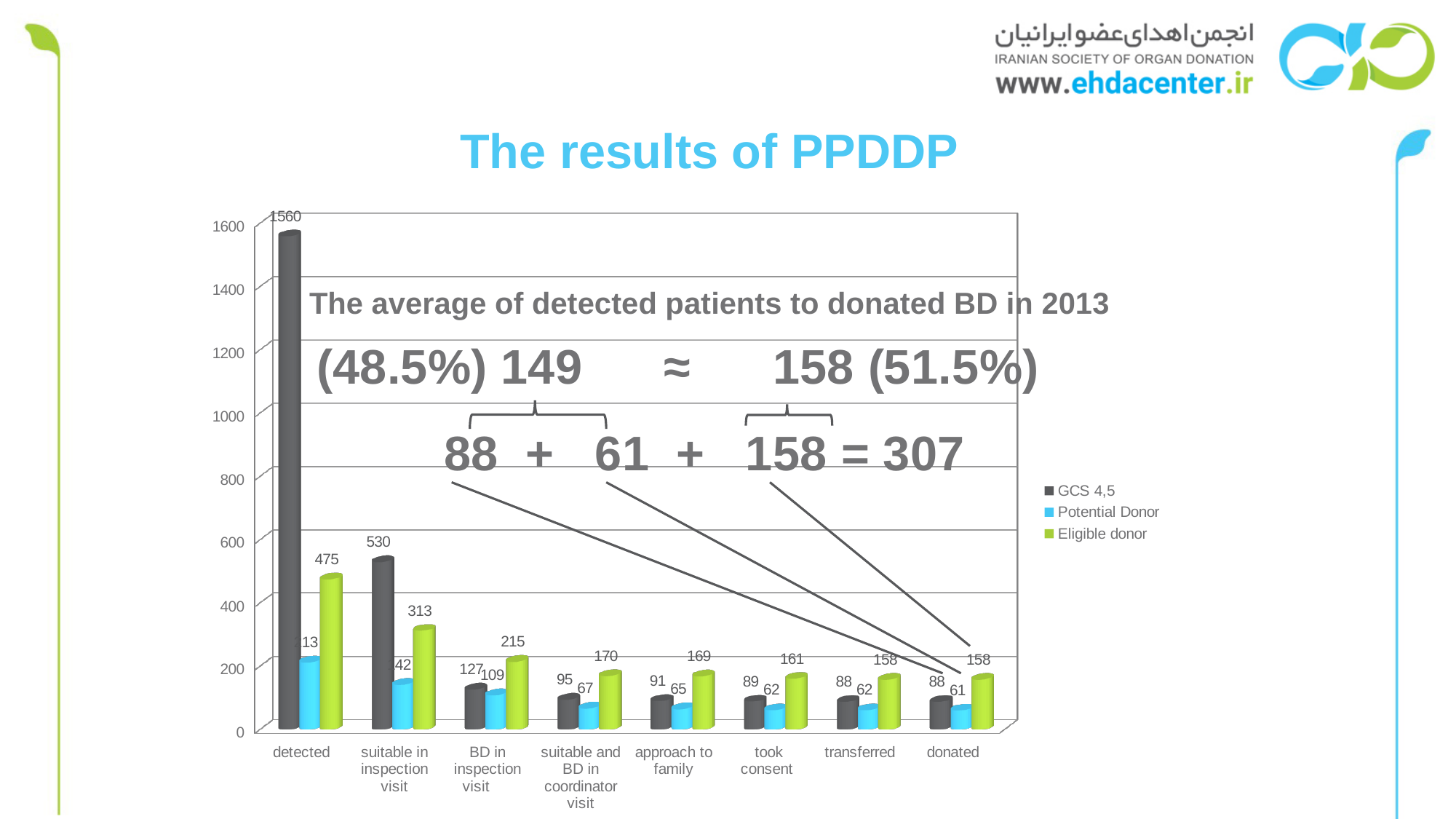
What is the Eligible donor value for 'suitable in inspection visit'? 313 Which category has the highest GCS 4,5 value? detected Does the GCS 4,5 value for 'detected' rise or fall across the categories from left to right? fall Which is larger: the Eligible donor value for 'took consent' or for 'transferred'? took consent How many categories are shown on the x axis? 8 What type of chart is shown on the slide? bar chart What is the Potential Donor value for 'BD in inspection visit'? 109 How many series does the legend list? 3 What is the difference between the GCS 4,5 values for 'detected' and 'suitable in inspection visit'? 1030 What is the GCS 4,5 value for the 'detected' category? 1560 What is the Eligible donor value for 'donated'? 158 Which category has the lowest Potential Donor value? donated